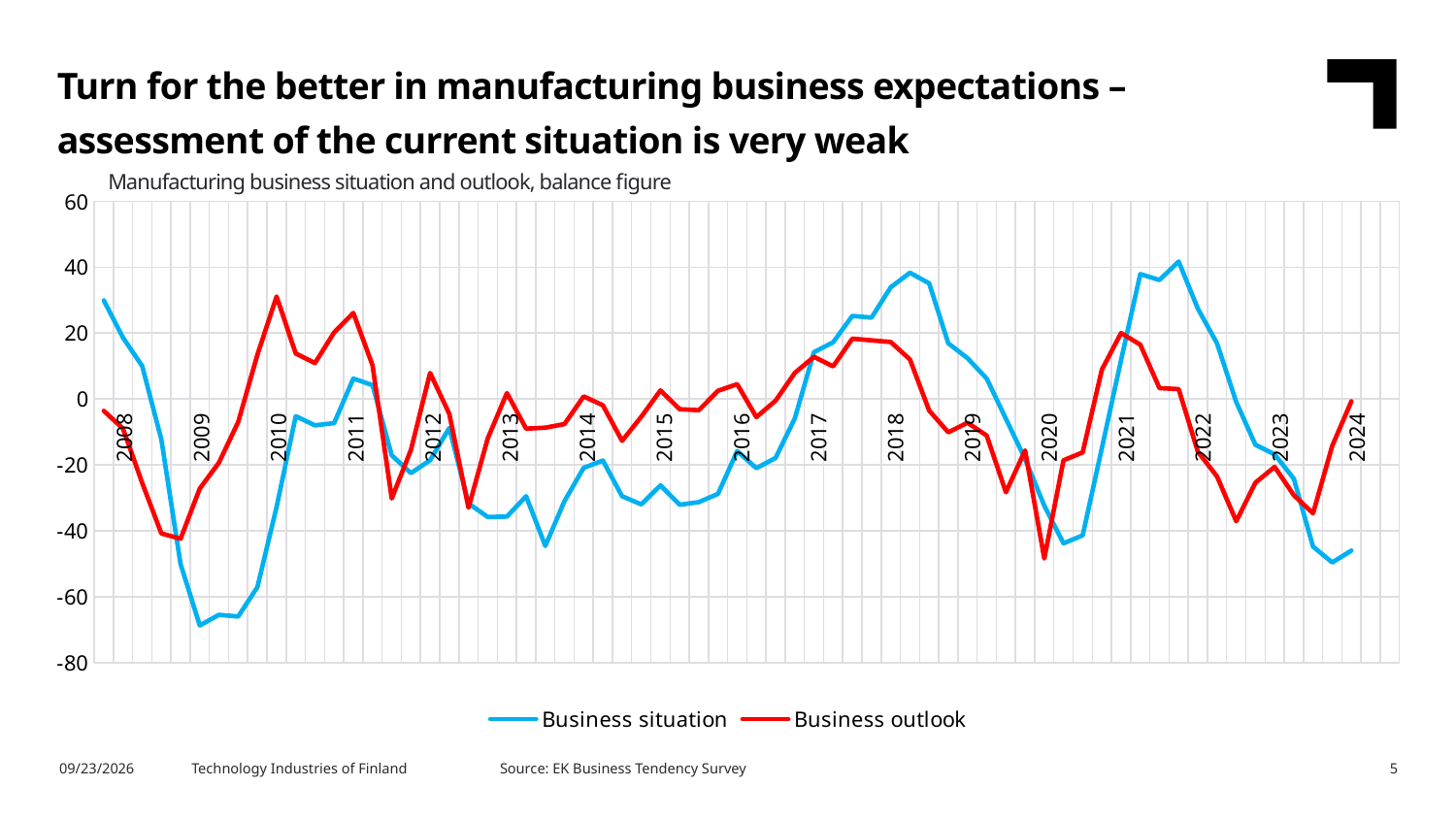
What kind of chart is shown on the slide? Line chart What is the title of the chart? Manufacturing business situation and outlook, balance figure Is the value of the Business outlook line at its 2020 low greater or less than -40? less At the end of 2024, which series has the higher value, Business situation or Business outlook? Business outlook Is the lowest value of the Business situation line in 2009 greater or less than -60? less Does the Business situation line rise or fall from its 2021 peak to 2024? Fall Which series is drawn in red? Business outlook How many year labels are shown on the x axis? 17 At the start of 2008, which series has the higher value, Business situation or Business outlook? Business situation How many series does the legend list? 2 In which year does the Business situation line reach its lowest point? 2009 Is the value of the Business situation line at the end of 2024 greater or less than -40? less